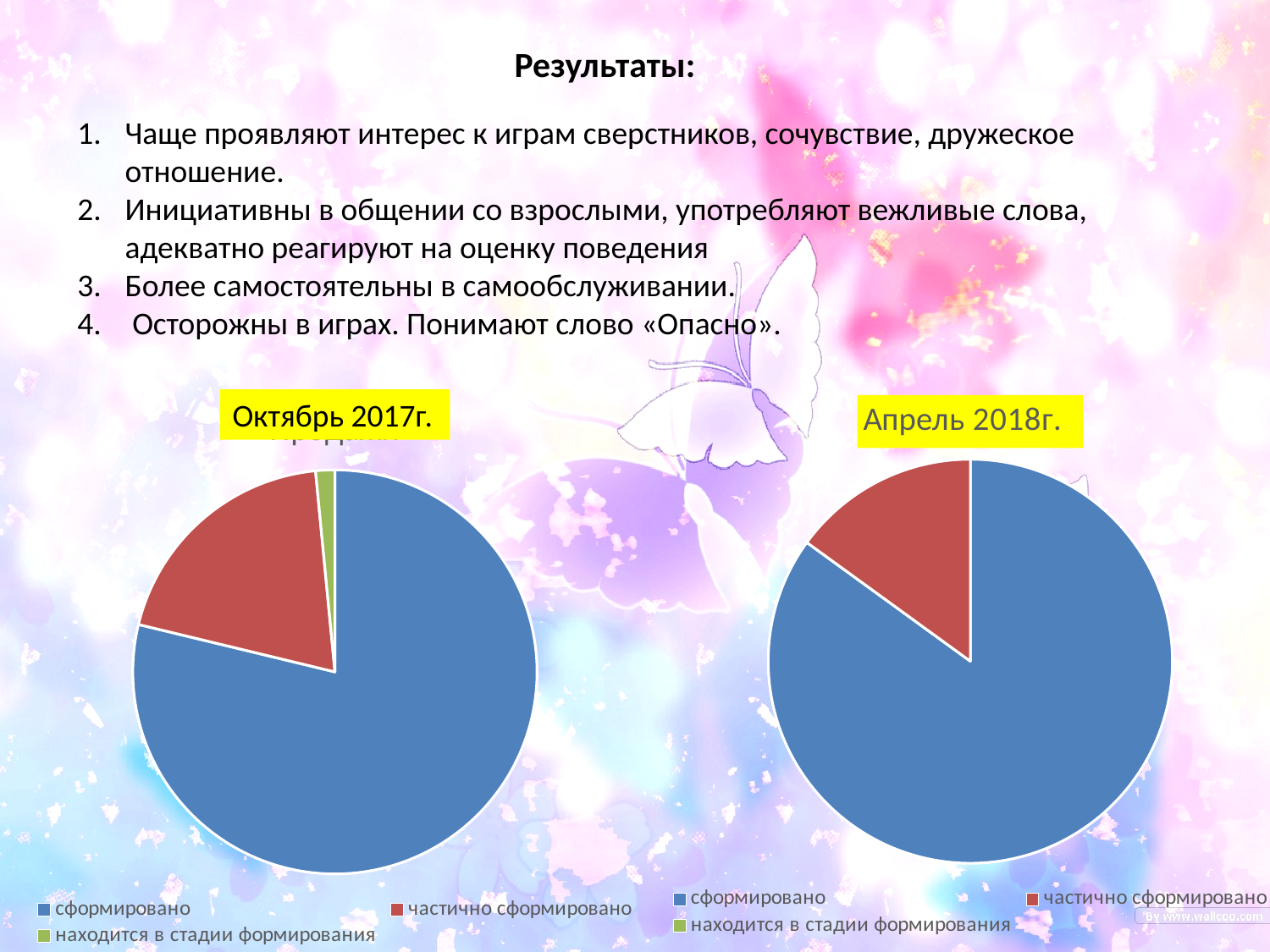
What kind of chart is the "Октябрь 2017г." chart? pie chart What kind of chart is the "Апрель 2018г." chart? pie chart In the "Апрель 2018г." chart, which category has the largest slice? сформировано In the "Октябрь 2017г." chart, which is larger: "частично сформировано" or "находится в стадии формирования"? частично сформировано How many entries does the legend of the "Октябрь 2017г." chart list? 3 How many slices are visible in the "Октябрь 2017г." pie? 3 In the "Апрель 2018г." chart, which is larger: "сформировано" or "частично сформировано"? сформировано How many entries does the legend of the "Апрель 2018г." chart list? 3 In the "Октябрь 2017г." chart, which category has the largest slice? сформировано In the "Октябрь 2017г." chart, what colour is the "частично сформировано" slice? red How many slices are visible in the "Апрель 2018г." pie? 2 In the "Октябрь 2017г." chart, which category has the smallest slice? находится в стадии формирования